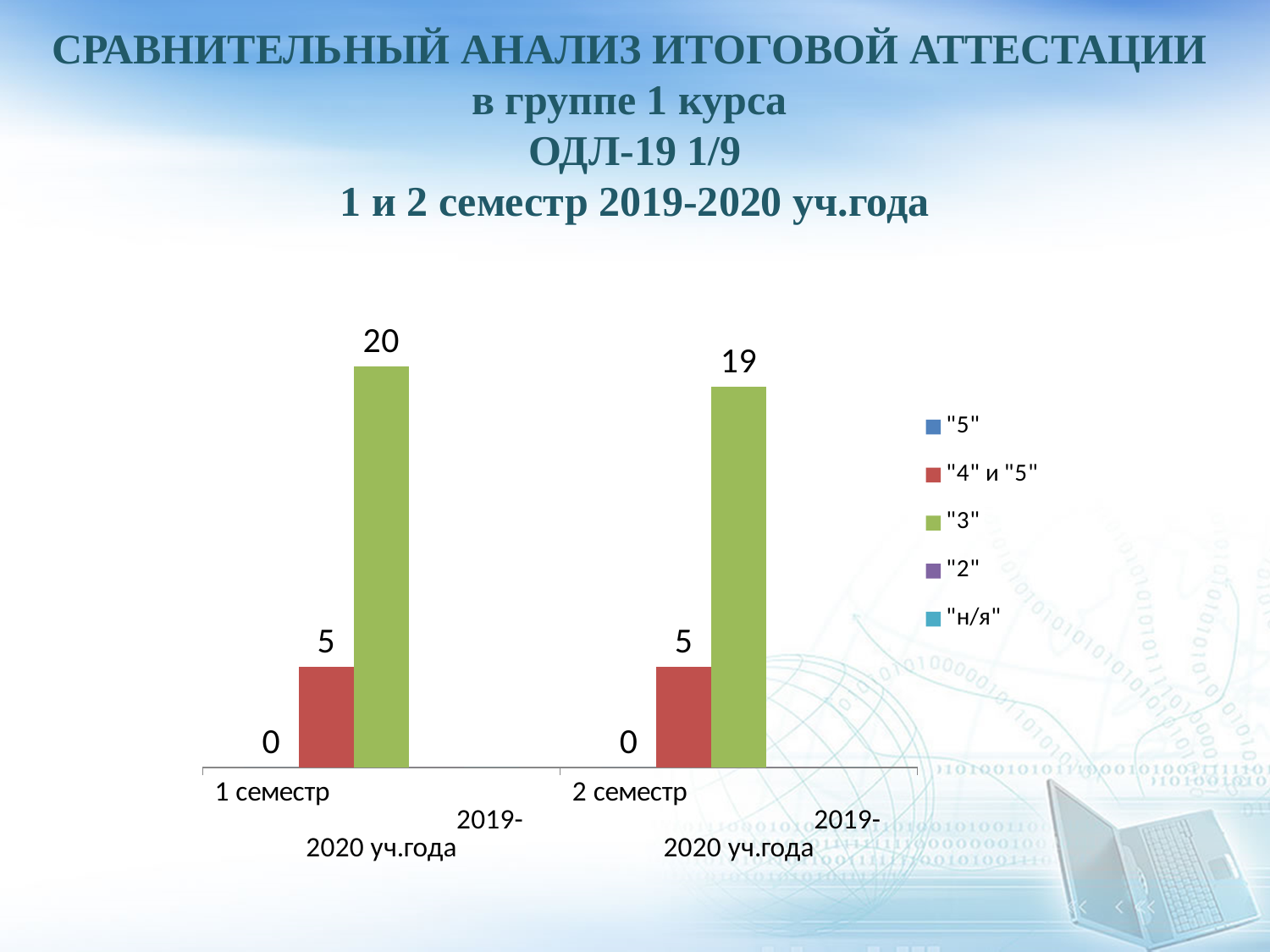
What is the value for "3" in 1 семестр 2019-2020 уч.года? 20 What is the value for "4" и "5" in 1 семестр 2019-2020 уч.года? 5 Which is larger: the "3" value in 1 семестр or in 2 семестр 2019-2020 уч.года? 1 семестр What colour are the bars for the "3" series? green What is the value for "4" и "5" in 2 семестр 2019-2020 уч.года? 5 Which series has the highest value in 2 семестр 2019-2020 уч.года? "3" How many series does the legend list? 5 What is the difference between the "3" values for 1 семестр and 2 семестр 2019-2020 уч.года? 1 What is the value for "5" in 1 семестр 2019-2020 уч.года? 0 What is the value for "3" in 2 семестр 2019-2020 уч.года? 19 What kind of chart is shown on the slide? bar chart How many categories are shown on the x axis? 2